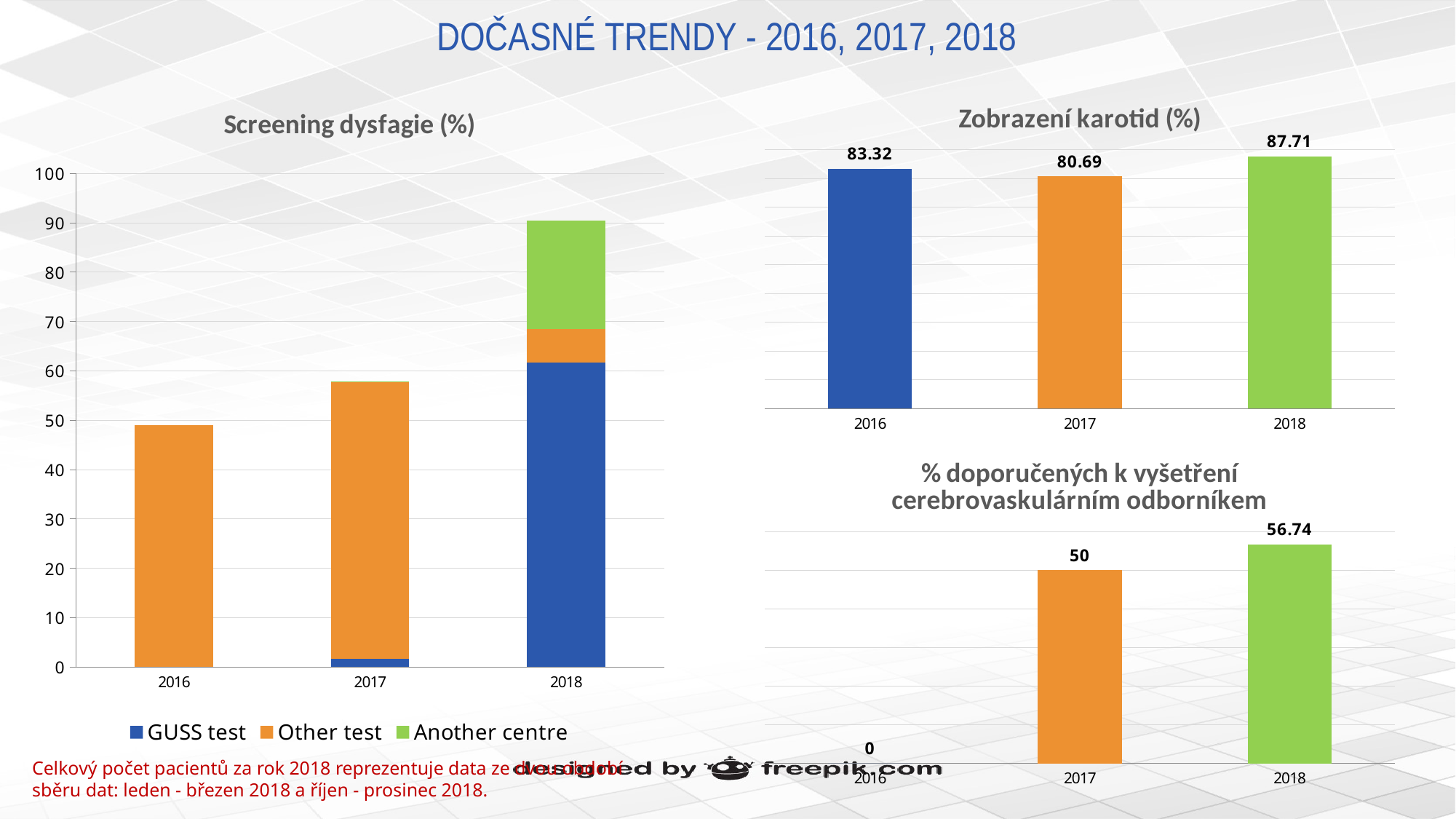
In the 'Screening dysfagie (%)' chart, is the total stacked value for 2018 greater or less than 80? greater In the '% doporučených k vyšetření cerebrovaskulárním odborníkem' chart, which year has the highest value? 2018 In the 'Zobrazení karotid (%)' chart, what is the value for 2018? 87.71 In the '% doporučených k vyšetření cerebrovaskulárním odborníkem' chart, what is the value for 2016? 0 What kind of chart is the 'Screening dysfagie (%)' chart? stacked bar chart In the '% doporučených k vyšetření cerebrovaskulárním odborníkem' chart, do the values rise or fall from 2016 to 2018? rise In the '% doporučených k vyšetření cerebrovaskulárním odborníkem' chart, what is the value for 2017? 50 In the 'Zobrazení karotid (%)' chart, which year has the lowest value? 2017 In the 'Zobrazení karotid (%)' chart, what is the difference between the 2018 and 2016 values? 4.39 How many series does the legend of the 'Screening dysfagie (%)' chart list? 3 In the 'Zobrazení karotid (%)' chart, what is the value for 2017? 80.69 In the 'Screening dysfagie (%)' chart, is the total stacked value for 2016 greater or less than 40? greater